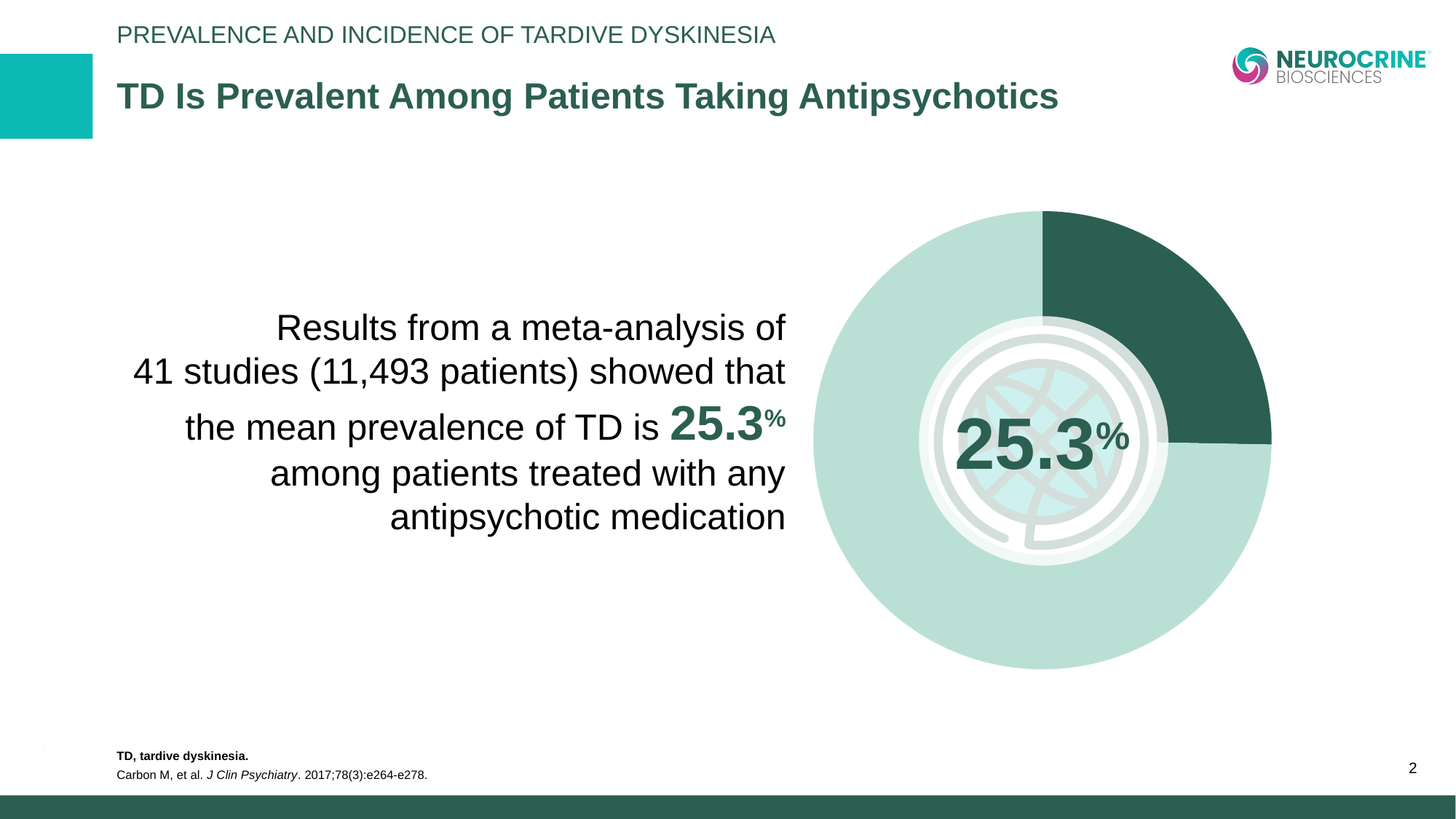
Which slice of the pie chart is larger, the dark green slice or the light green slice? The light green slice What colour is the slice of the pie chart that represents the 25.3% prevalence of TD? Dark green What kind of chart is shown on the slide? Doughnut chart What share of the pie chart does the dark green slice represent? 25.3% What value is printed in the centre of the pie chart? 25.3% How many slices does the pie chart have? 2 How many studies were included in the meta-analysis that the pie chart is based on? 41 Is the dark green slice of the pie chart greater or less than 20% of the pie? greater How many patients were included in the meta-analysis that the pie chart is based on? 11,493 What does the 25.3% shown in the pie chart represent? The mean prevalence of TD among patients treated with any antipsychotic medication Is the dark green slice of the pie chart greater or less than 50% of the pie? less